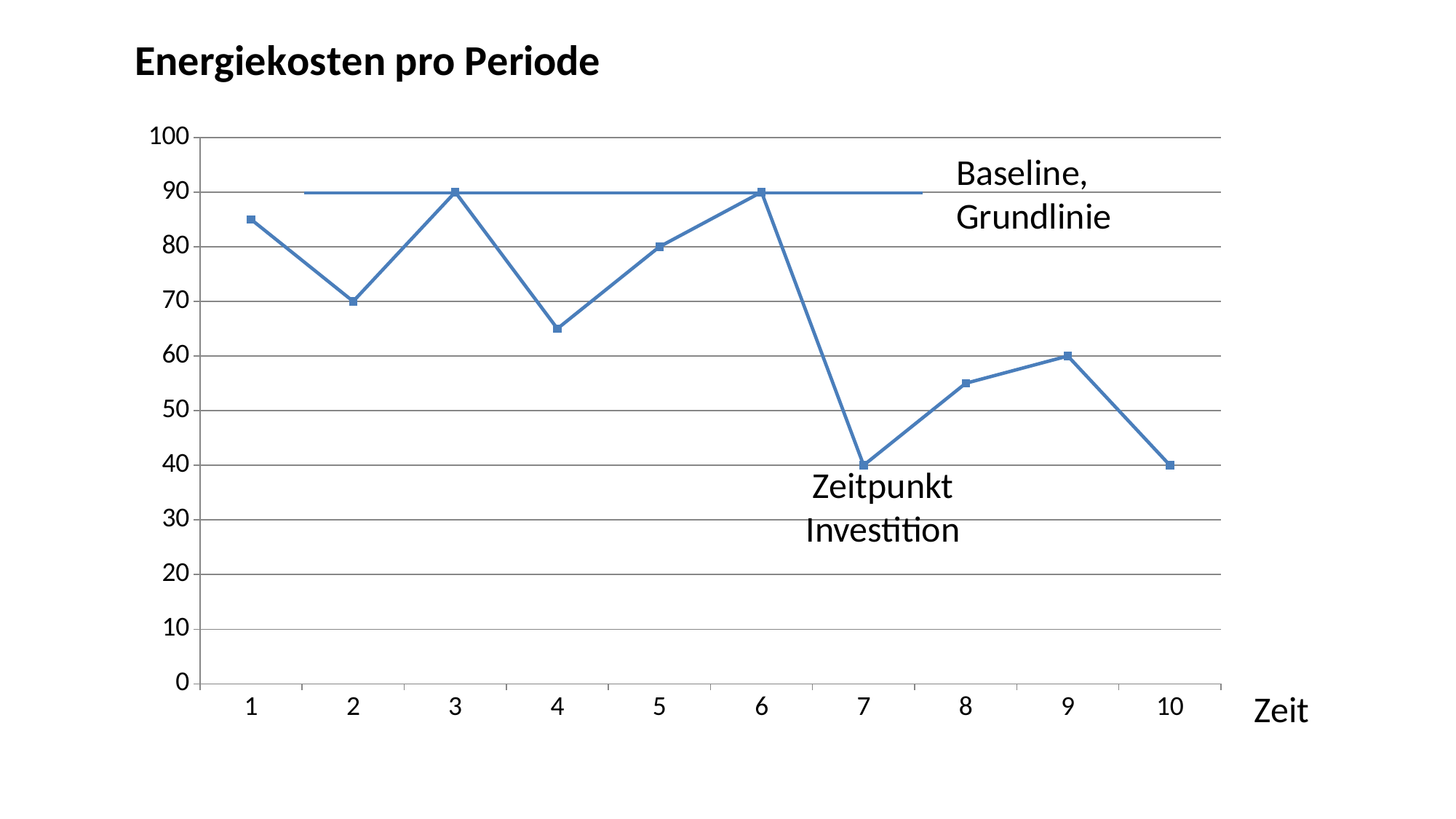
Is the value for period 1 greater or less than 80? greater What is the value for period 9? 60 What is the difference between the value for period 6 and the value for period 7? 50 What type of chart is shown on the slide? line chart At what level is the horizontal line labelled 'Baseline, Grundlinie' drawn? 90 What is the value for period 2? 70 How many periods are plotted along the x axis? 10 Is the value for period 4 greater or less than 70? less What is the value for period 7? 40 Which has the larger value, period 5 or period 9? period 5 Do the values rise or fall from period 6 to period 7? fall What is the title of the chart? Energiekosten pro Periode